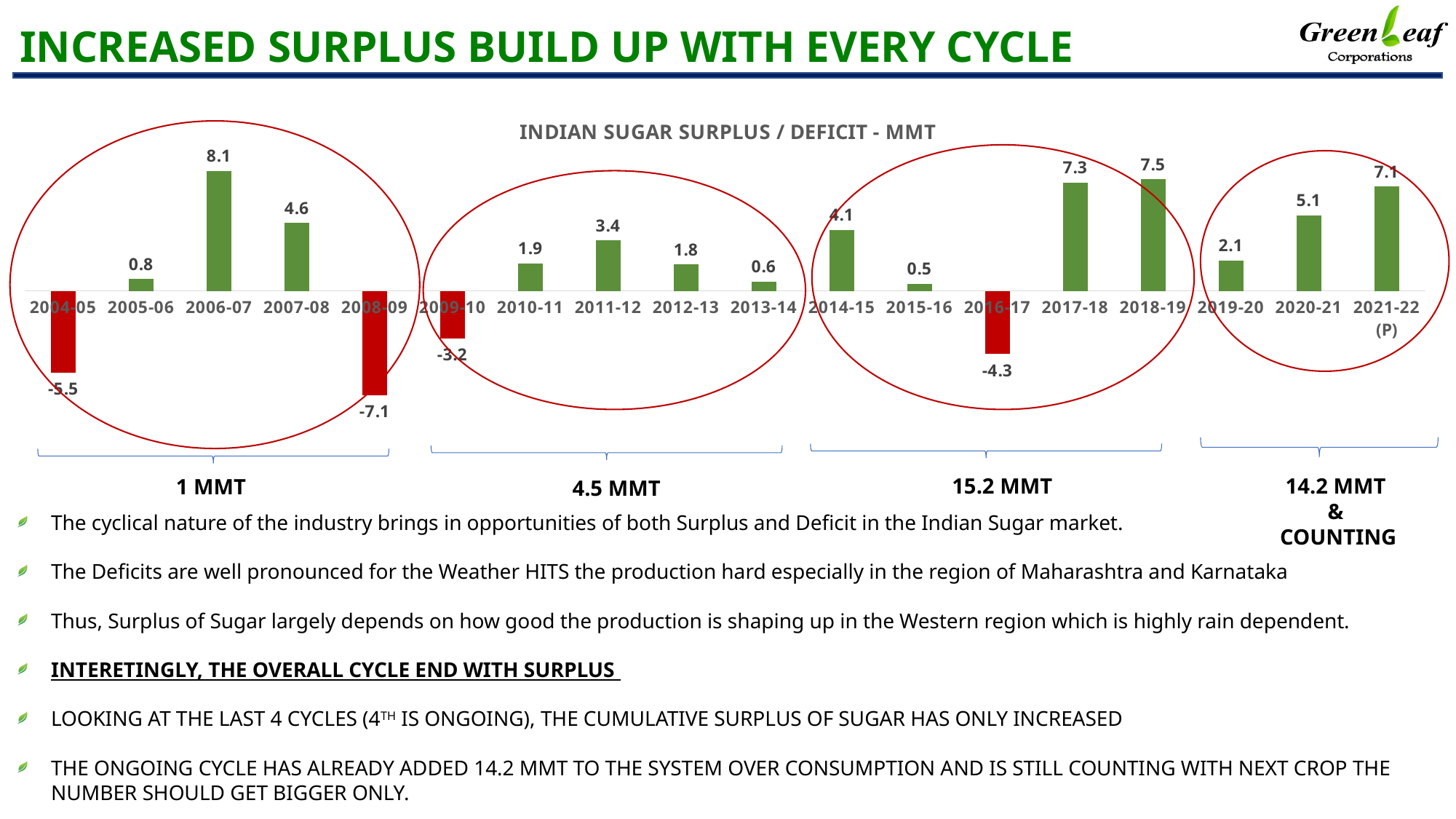
Which is larger, the value for 2011-12 or the value for 2010-11? 2011-12 What is the value for 2016-17? -4.3 Do the values rise or fall from 2019-20 to 2021-22 (P)? rise How many years show a negative (deficit) value? 4 What is the difference between the values for 2018-19 and 2017-18? 0.2 What kind of chart is shown? bar chart How many years are shown on the x axis? 18 Which year has the lowest value? 2008-09 What is the title of the chart? INDIAN SUGAR SURPLUS / DEFICIT - MMT Which year has the highest value? 2006-07 What is the value for 2006-07? 8.1 What is the value for 2021-22 (P)? 7.1